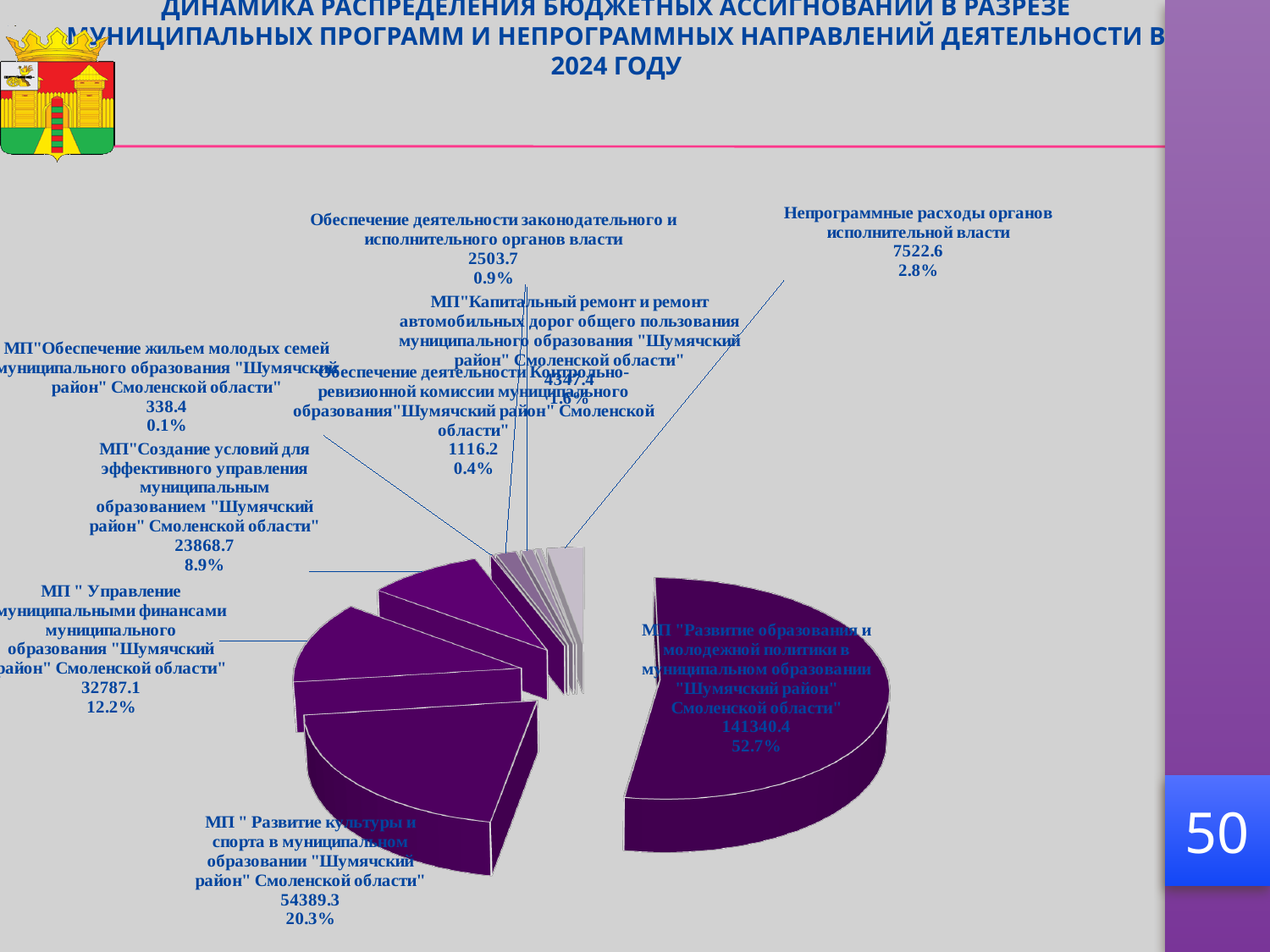
What is the difference between the values for МП "Развитие культуры и спорта" (54389.3) and МП "Управление муниципальными финансами" (32787.1)? 21602.2 How many slices does the pie chart have? 9 Which is larger: МП "Управление муниципальными финансами" or МП "Развитие культуры и спорта"? МП "Развитие культуры и спорта" What percentage is shown for Обеспечение деятельности законодательного и исполнительного органов власти? 0.9% What percentage is shown for МП "Создание условий для эффективного управления муниципальным образованием"? 8.9% What is the value shown for Непрограммные расходы органов исполнительной власти? 7522.6 What is the value shown for Обеспечение деятельности Контрольно-ревизионной комиссии? 1116.2 What is the value shown for МП "Развитие культуры и спорта в муниципальном образовании "Шумячский район" Смоленской области"? 54389.3 What kind of chart is shown on the slide? pie chart Which category has the largest share of the pie? МП "Развитие образования и молодежной политики в муниципальном образовании "Шумячский район" Смоленской области" What share of the pie does МП "Развитие образования и молодежной политики" account for? 52.7% Which category has the smallest share of the pie? МП "Обеспечение жильем молодых семей муниципального образования "Шумячский район" Смоленской области"